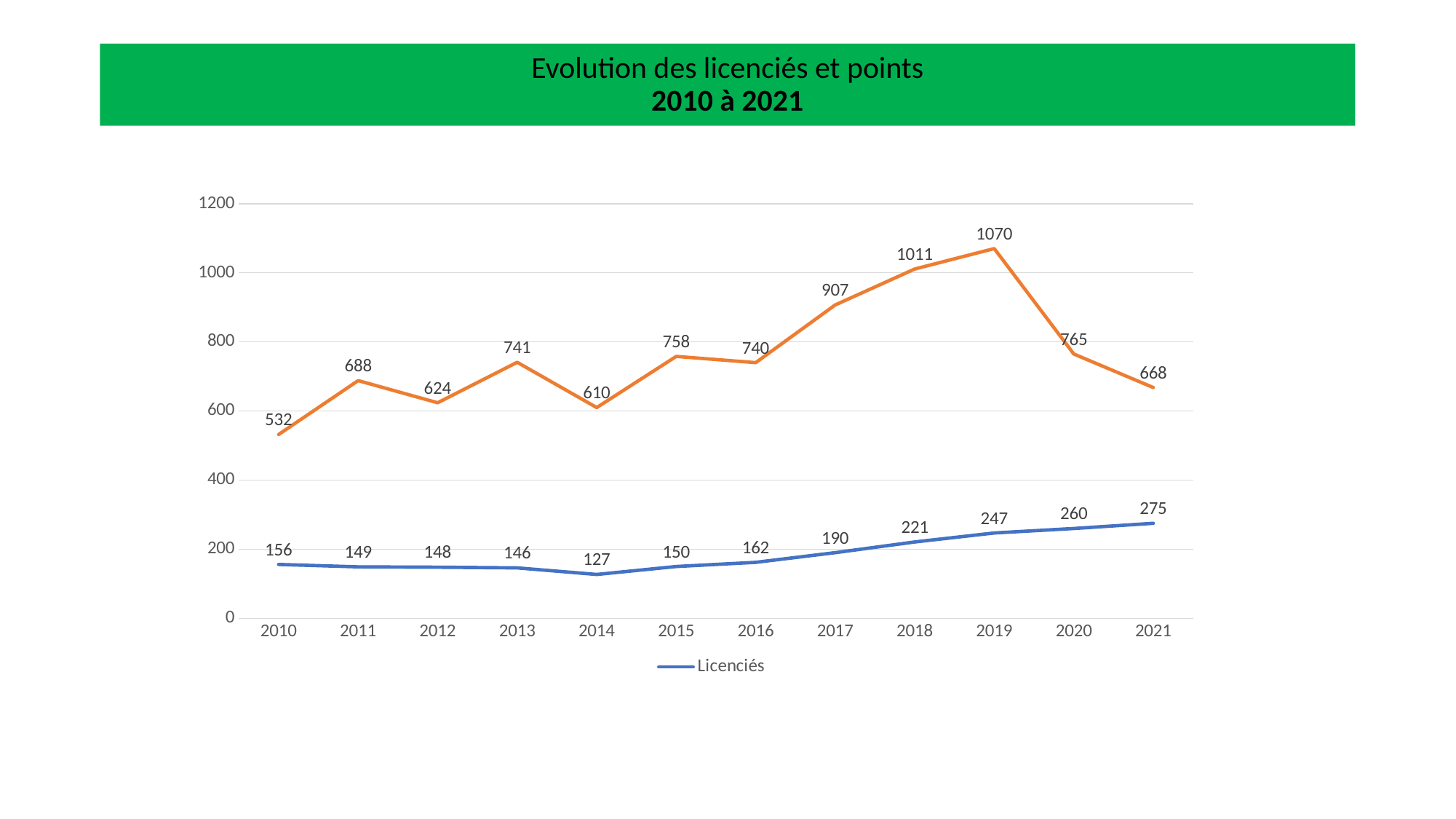
What type of chart is shown on the slide? line chart What is the value of Licenciés in 2021? 275 What is the difference between the orange line values in 2019 and 2020? 305 How many years are shown on the x axis? 12 In which year is the orange line at its highest? 2019 How many series does the legend list? 1 Which is larger: the orange line value in 2013 or in 2015? 2015 What is the value of the orange line in 2010? 532 What is the value of the orange line in 2019? 1070 In which year is the Licenciés value lowest? 2014 What is the value of Licenciés in 2014? 127 What is the difference between the Licenciés values in 2021 and 2010? 119